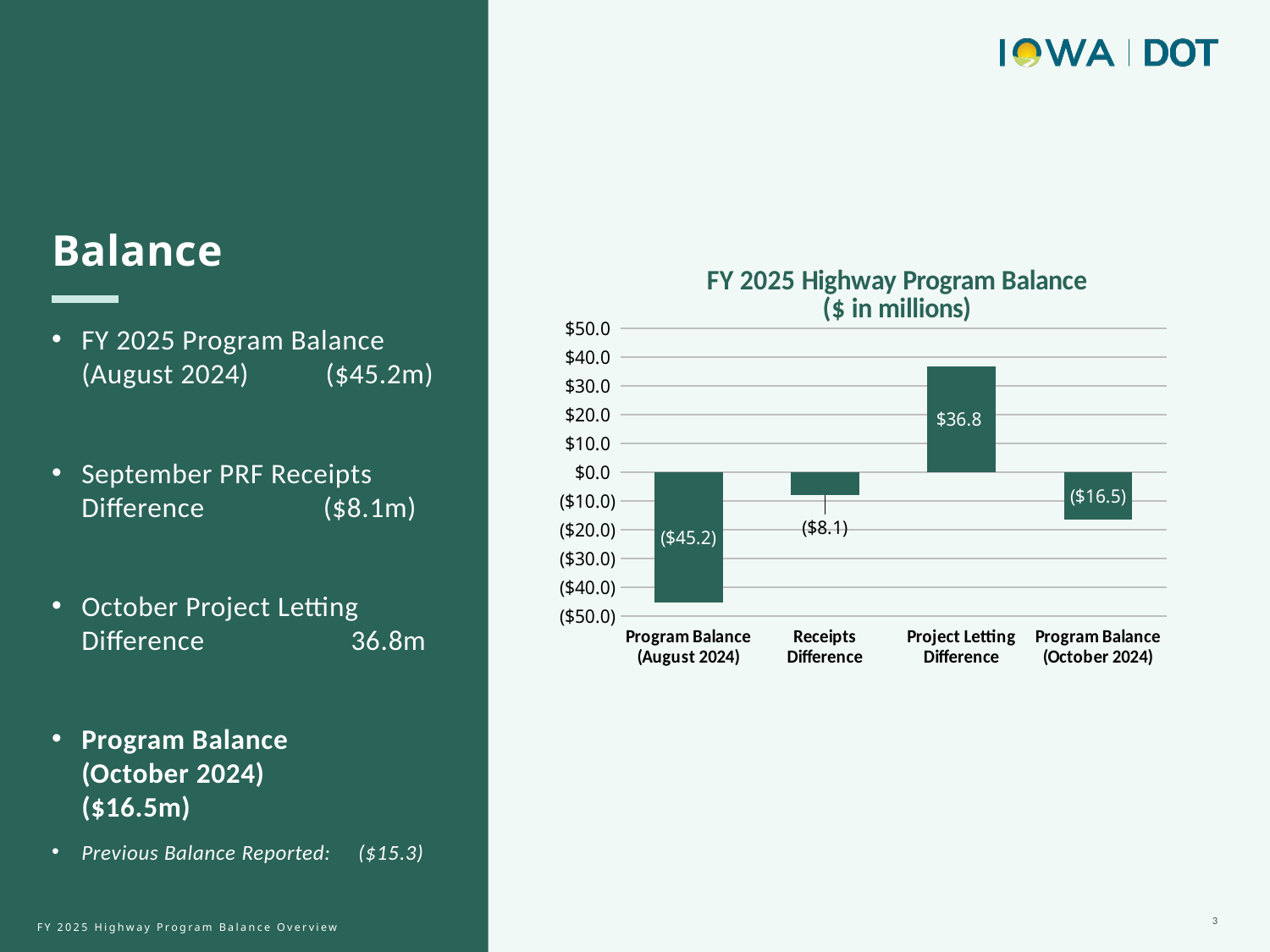
What is the value for Project Letting Difference? $36.8 What is the title of the chart? FY 2025 Highway Program Balance ($ in millions) What is the value for Program Balance (October 2024)? ($16.5) How many categories are shown on the x axis? 4 Is the value for Project Letting Difference greater or less than $30.0? greater How many bars extend above the $0.0 line? 1 What is the value for Program Balance (August 2024)? ($45.2) Which category has the highest value? Project Letting Difference What is the value for Receipts Difference? ($8.1) Which is larger, the value for Receipts Difference or the value for Program Balance (October 2024)? Receipts Difference What kind of chart is shown? bar chart Which category has the lowest value? Program Balance (August 2024)